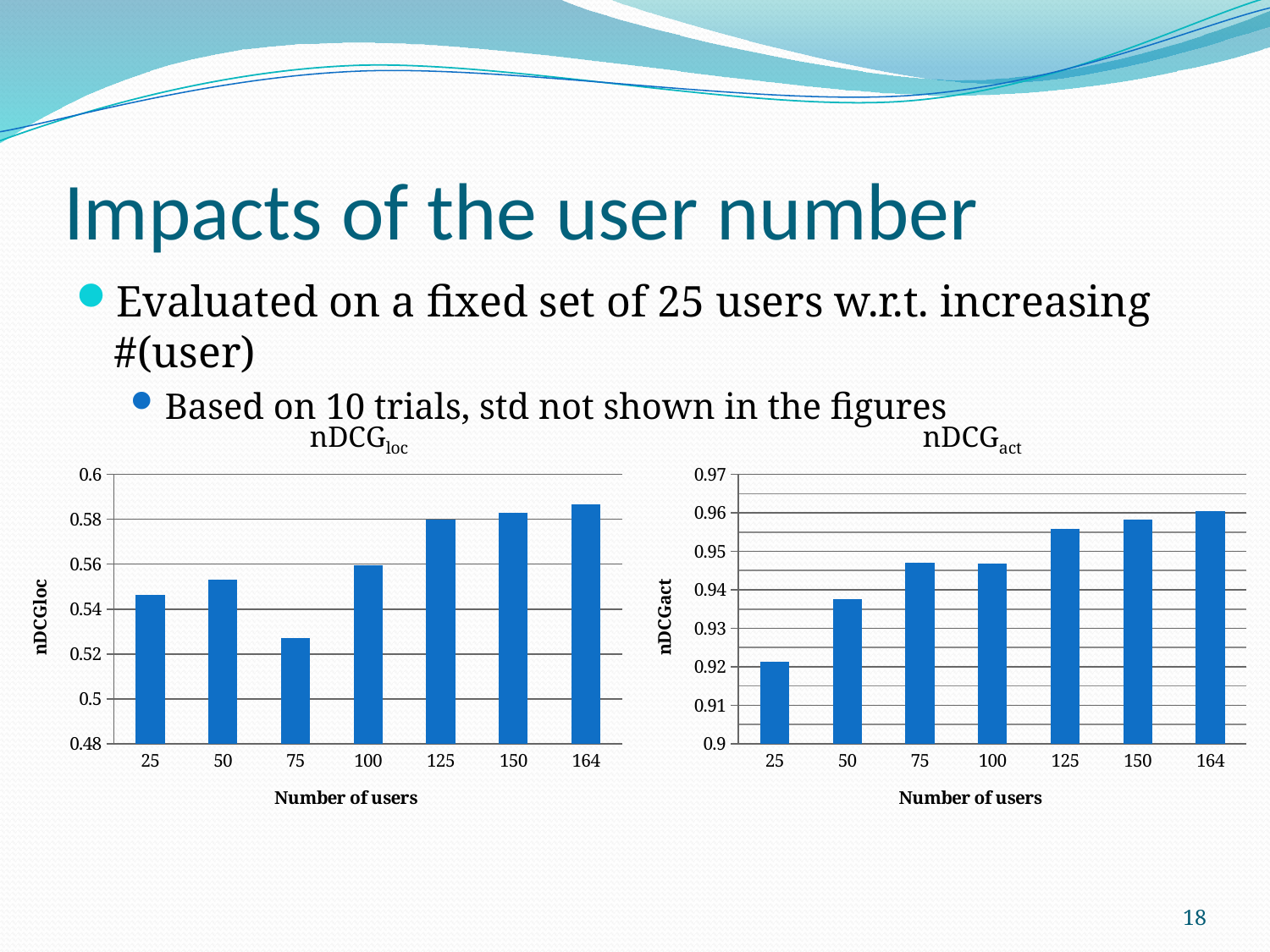
In the nDCGact chart on the right, is the value for 125 users greater or less than 0.95? greater In the nDCGact chart on the right, is the value for 25 users greater or less than 0.93? less What is the x-axis label of the nDCGact chart on the right? Number of users How many user-number categories are shown on the x axis of the nDCGact chart on the right? 7 What kind of chart is the nDCGloc chart on the left? bar chart In the nDCGloc chart on the left, which number of users has the highest nDCGloc value? 164 In the nDCGloc chart on the left, which number of users has the lowest nDCGloc value? 75 In the nDCGloc chart on the left, is the value for 75 users greater or less than 0.54? less In the nDCGloc chart on the left, which has the larger value: 25 users or 75 users? 25 users In the nDCGact chart on the right, which number of users has the lowest nDCGact value? 25 In the nDCGact chart on the right, which has the larger value: 25 users or 164 users? 164 users